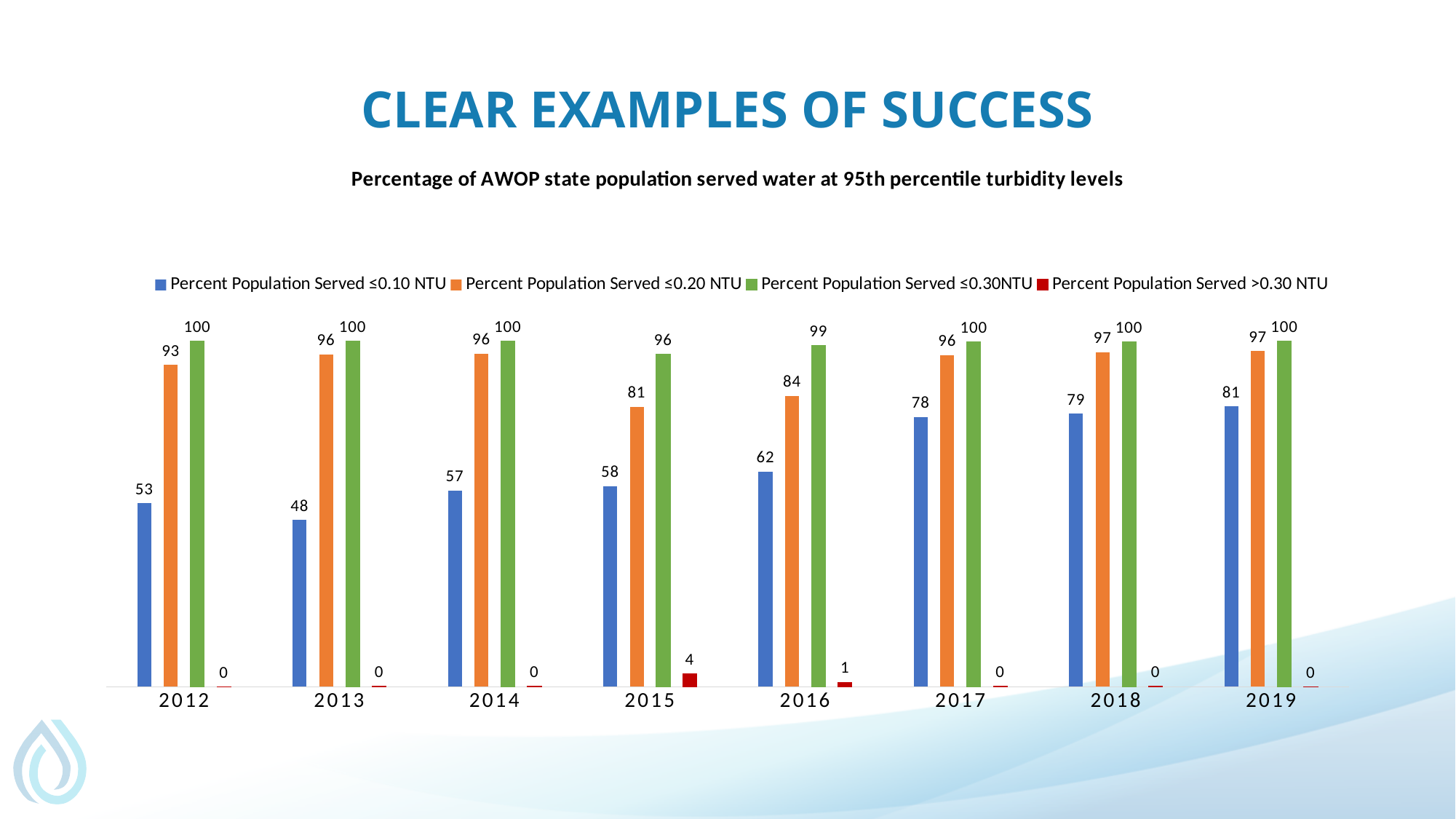
What is the chart's title? Percentage of AWOP state population served water at 95th percentile turbidity levels How many series does the legend list? 4 What is the value for Percent Population Served ≤0.20 NTU in 2015? 81 What is the value for Percent Population Served >0.30 NTU in 2015? 4 What kind of chart is shown on the slide? Bar chart Which is larger, the Percent Population Served ≤0.20 NTU value in 2016 or in 2017? 2017 How many years are shown on the x axis? 8 What is the value for Percent Population Served ≤0.10 NTU in 2012? 53 Which year has the lowest value for Percent Population Served ≤0.10 NTU? 2013 What is the difference between the Percent Population Served ≤0.10 NTU values for 2019 and 2012? 28 What is the value for Percent Population Served ≤0.30NTU in 2016? 99 Which year has the highest value for Percent Population Served ≤0.10 NTU? 2019